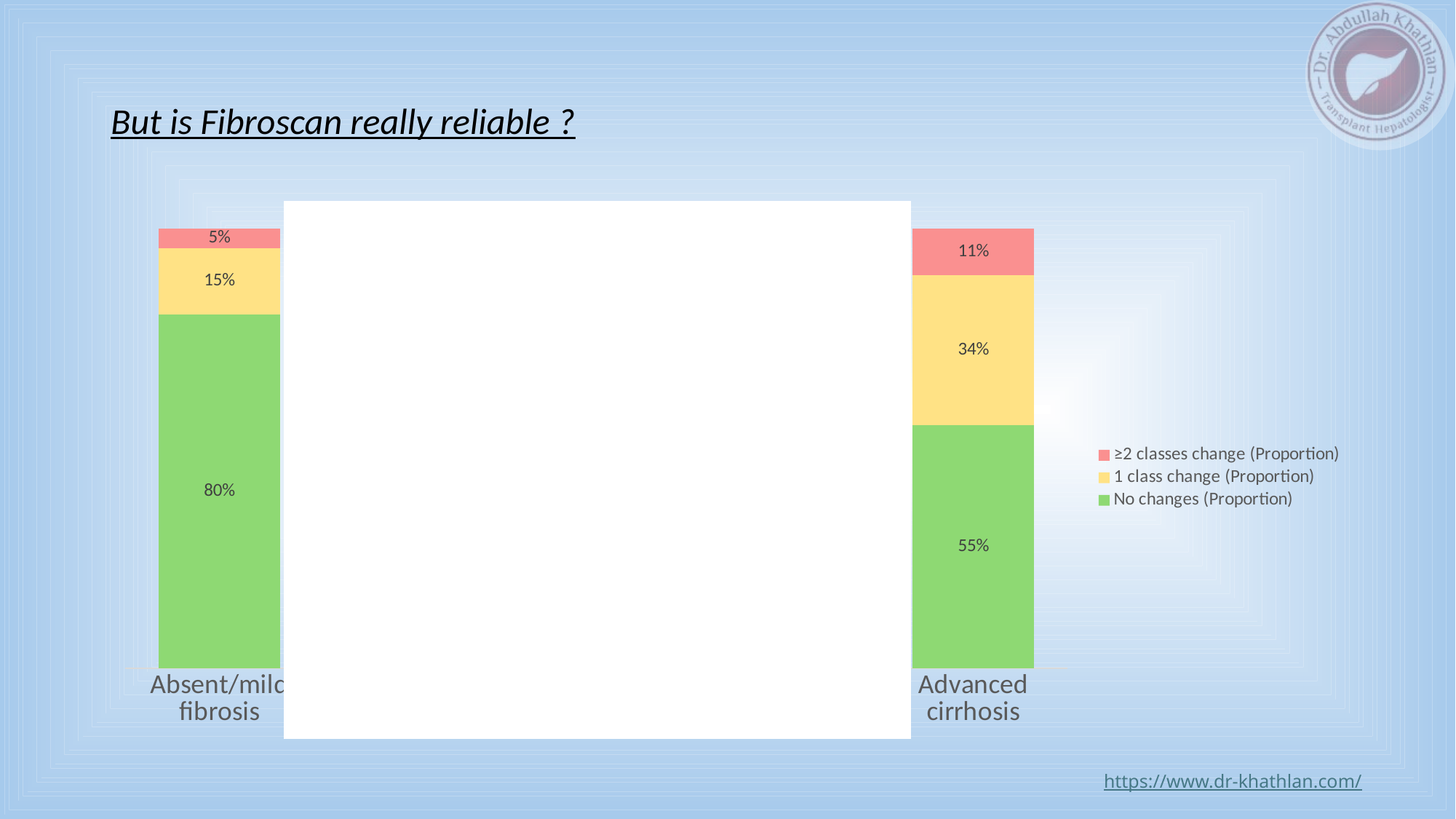
What kind of chart is shown on the slide? Stacked bar chart What is the '≥2 classes change (Proportion)' value for Advanced cirrhosis? 11% What is the '1 class change (Proportion)' value for Absent/mild fibrosis? 15% Which category has the higher 'No changes (Proportion)' value, Absent/mild fibrosis or Advanced cirrhosis? Absent/mild fibrosis What is the difference between the 'No changes (Proportion)' values for Absent/mild fibrosis and Advanced cirrhosis? 25% What is the difference between the '≥2 classes change (Proportion)' values for Advanced cirrhosis and Absent/mild fibrosis? 6% How many series does the legend list? 3 What is the total of the stacked bar for Advanced cirrhosis? 100% What is the 'No changes (Proportion)' value for Absent/mild fibrosis? 80% What is the '1 class change (Proportion)' value for Advanced cirrhosis? 34% Which colour represents '1 class change (Proportion)' in the legend? Yellow What is the 'No changes (Proportion)' value for Advanced cirrhosis? 55%